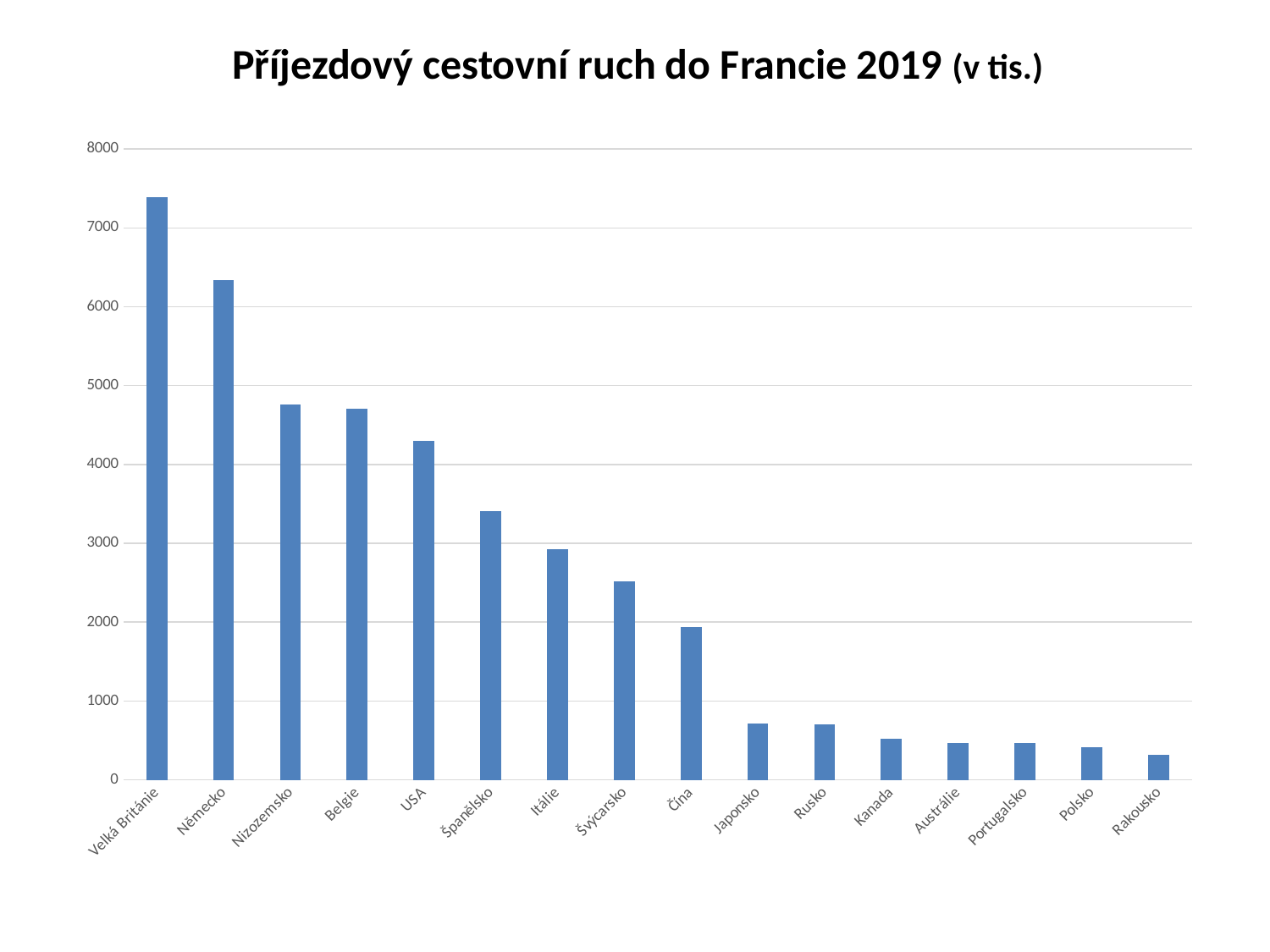
Is the value for Německo greater or less than 6000? greater Is the value for Velká Británie greater or less than 7000? greater Is the value for Itálie greater or less than 3000? less How many countries are shown on the x axis? 16 What kind of chart is shown on the slide? bar chart Which country has the lowest value in the chart? Rakousko Which is larger, the value for Německo or the value for Nizozemsko? Německo Do the values rise or fall from left to right along the x axis? fall Which country has the highest value in the chart? Velká Británie